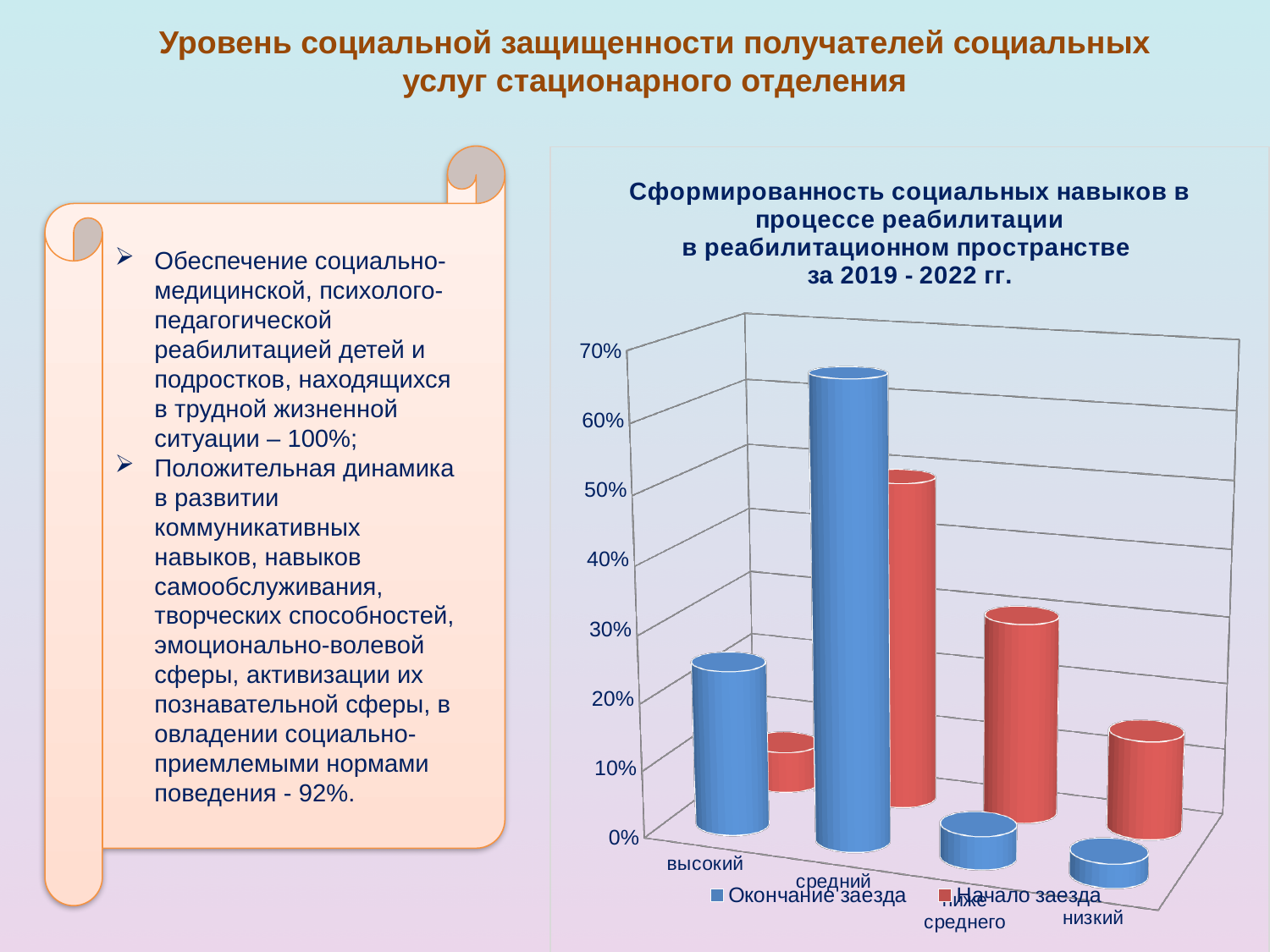
In the category 'ниже среднего', which series has the larger value: 'Окончание заезда' or 'Начало заезда'? Начало заезда For the series 'Начало заезда', which category has the lowest value? высокий Is the value for 'Окончание заезда' in the category 'средний' greater or less than 60%? greater Which colour represents the series 'Окончание заезда' in the chart? blue What kind of chart is shown on the slide? bar chart How many categories are shown along the x axis of the chart? 4 Is the value for 'Начало заезда' in the category 'ниже среднего' greater or less than 20%? greater For the series 'Окончание заезда', which category has the highest value? средний How many series does the chart legend list? 2 Is the value for 'Начало заезда' in the category 'средний' greater or less than 40%? greater For the series 'Начало заезда', which category has the highest value? средний In the category 'высокий', which series has the larger value: 'Окончание заезда' or 'Начало заезда'? Окончание заезда